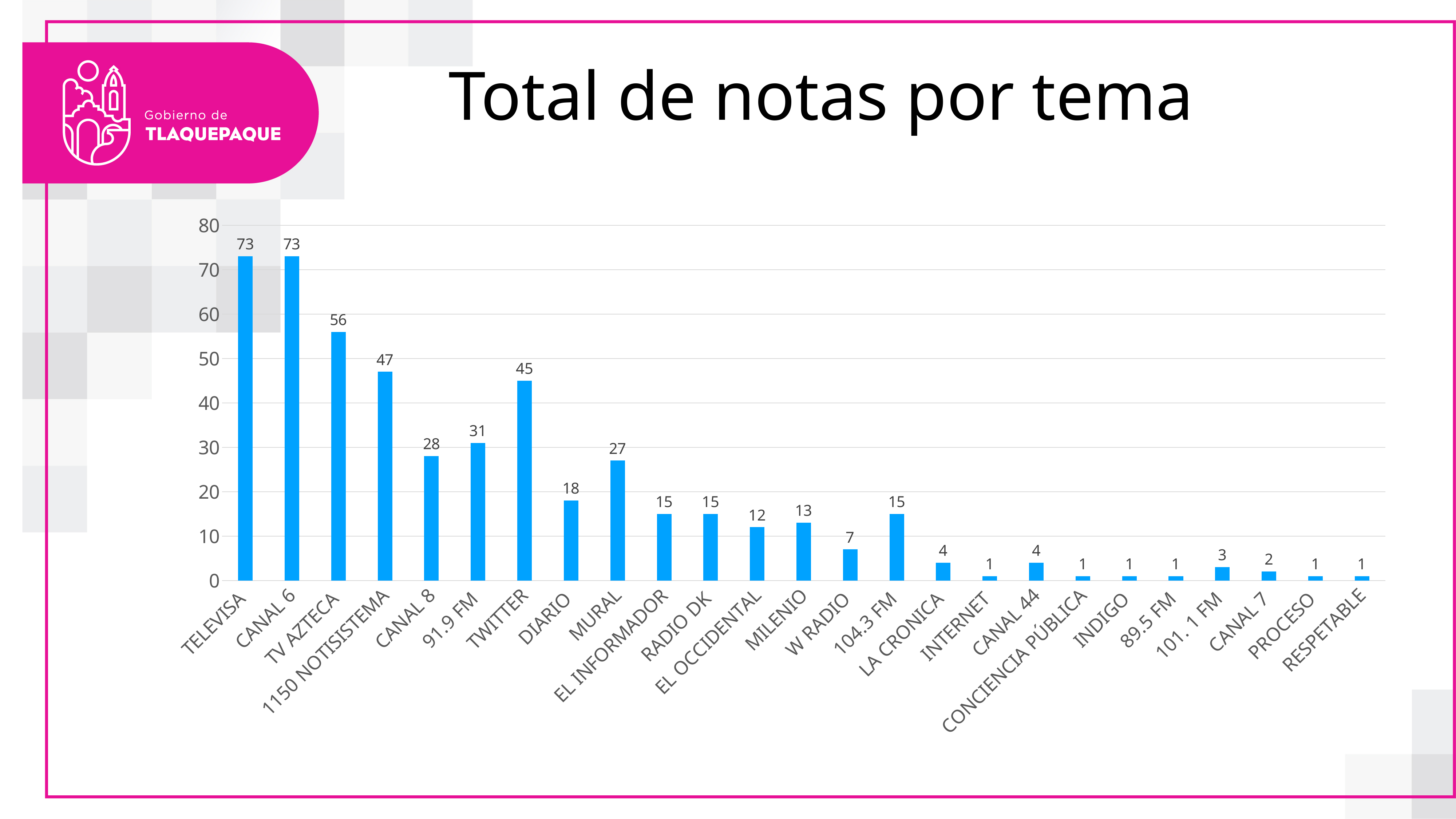
What is the title of the chart? Total de notas por tema What is the value for MURAL? 27 What is the value for W RADIO? 7 What is the value for 1150 NOTISISTEMA? 47 What is the difference between the values for 91.9 FM and CANAL 8? 3 How many categories are shown on the x axis? 25 Which is larger, the value for LA CRONICA or the value for CANAL 7? LA CRONICA What is the value for TWITTER? 45 What is the value for TV AZTECA? 56 What is the difference between the values for TELEVISA and TV AZTECA? 17 Which is larger, the value for DIARIO or the value for MILENIO? DIARIO What kind of chart is shown on the slide? Bar chart